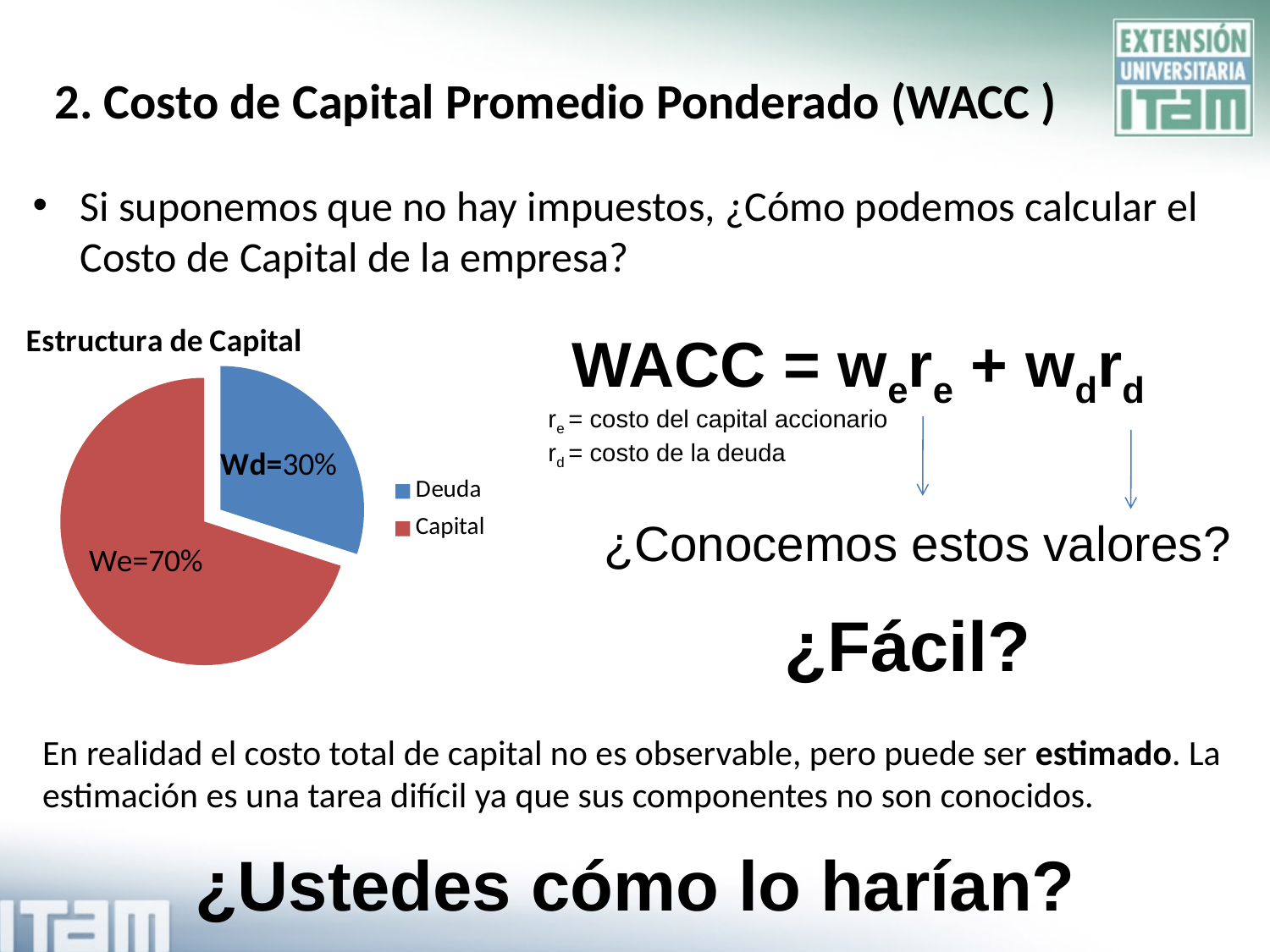
How many entries does the legend of the pie chart list? 2 What is the difference in percentage points between the Capital slice and the Deuda slice? 40 percentage points What is the title of the pie chart? Estructura de Capital What share of the pie does Deuda represent? 30% What kind of chart is shown under the title "Estructura de Capital"? pie chart What share of the pie does Capital represent? 70% Which slice of the pie chart is the largest? Capital Which slice of the pie chart is the smallest? Deuda What label is shown on the Deuda slice of the pie chart? Wd=30% How many slices does the pie chart have? 2 What colour is the Deuda slice in the pie chart? blue Which is larger in the pie chart, Deuda or Capital? Capital